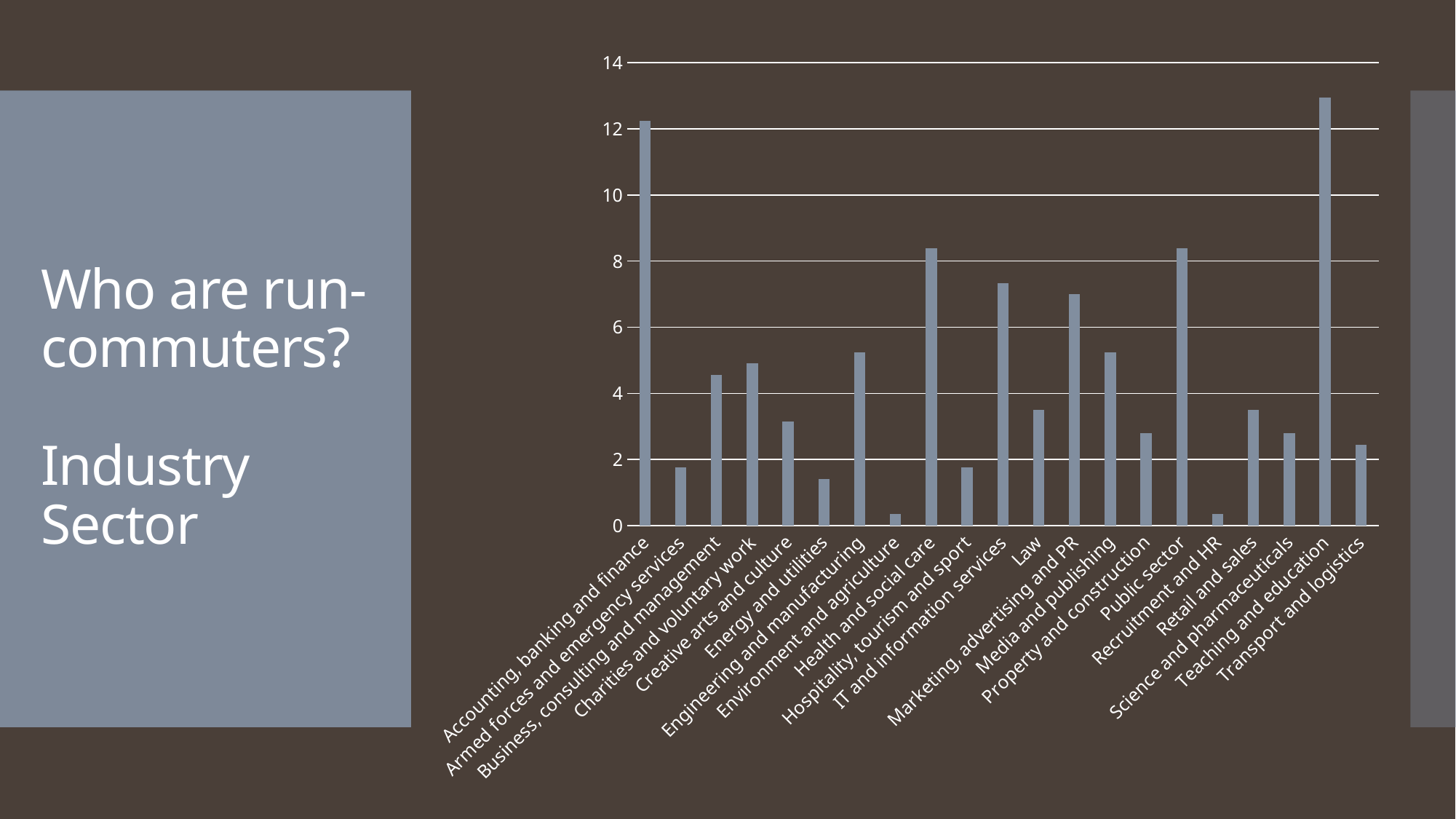
Is the value for Accounting, banking and finance greater or less than 10? greater Is the value for Public sector greater or less than 6? greater What kind of chart is shown on the slide? bar chart What is the highest value shown on the vertical axis of the chart? 14 Which is larger, the value for Armed forces and emergency services or the value for Business, consulting and management? Business, consulting and management Is the value for Health and social care greater or less than 6? greater Which industry sector has the highest bar on the chart? Teaching and education How many industry sector categories are plotted on the chart? 21 Which is larger, the value for Teaching and education or the value for Accounting, banking and finance? Teaching and education Which is larger, the value for Charities and voluntary work or the value for Creative arts and culture? Charities and voluntary work